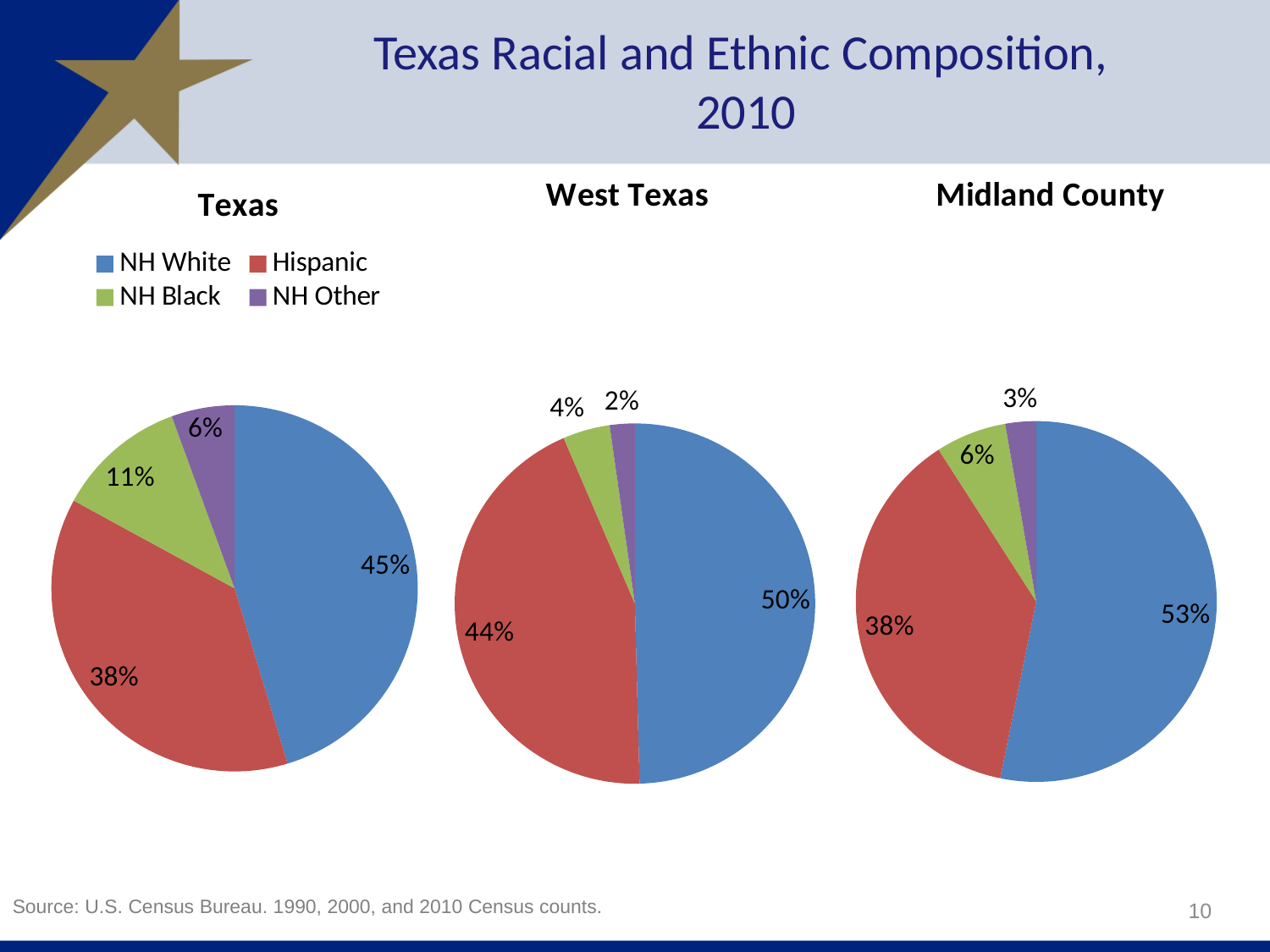
In the Texas pie chart, what is the difference between the NH White share and the Hispanic share? 7% In the Midland County pie chart, which group has the smallest share? NH Other What colour represents Hispanic in the pie charts? Red In the West Texas pie chart, what share is Hispanic? 44% How many entries does the legend list? 4 In the Texas pie chart, what share is NH White? 45% In the Texas pie chart, which group has the largest share? NH White In the Midland County pie chart, what share is NH Black? 6% How many slices does the West Texas pie chart have? 4 What type of chart is used for Midland County? Pie chart Which is larger: the NH Black share in the Texas pie chart or the NH Black share in the West Texas pie chart? Texas In the West Texas pie chart, what share is NH Other? 2%